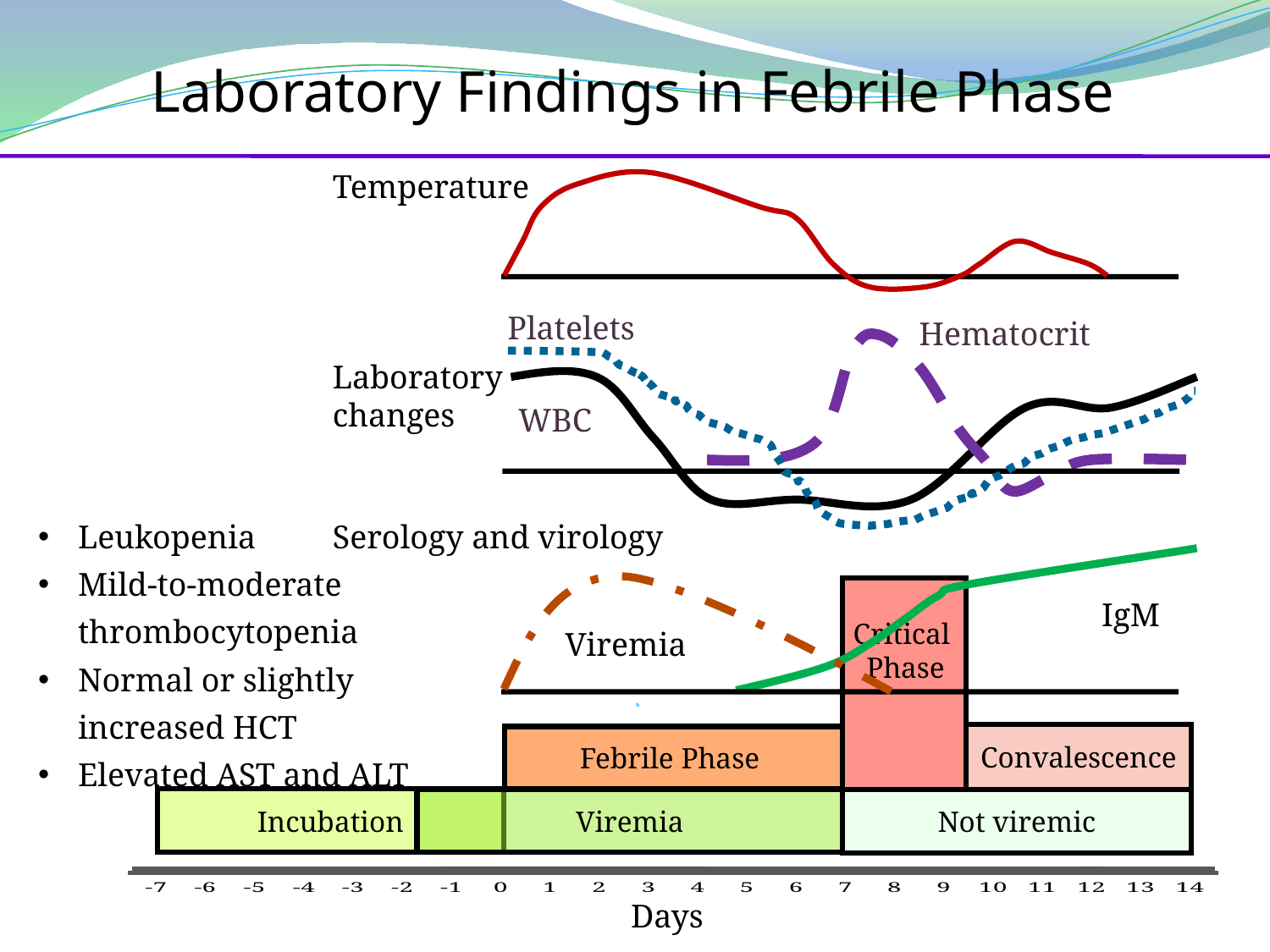
How many day ticks are shown on the horizontal axis, from -7 to 14? 22 What is the label on the horizontal axis of the diagram? Days Which phase follows the Critical Phase in the diagram? Convalescence Which phase is shown before day -2 on the bottom bar? Incubation Does the Platelets curve rise or fall between day 0 and day 7? fall Does the Hematocrit curve rise or fall between day 5 and day 7? rise Does the Temperature curve rise or fall between day 3 and day 7? fall Which bottom-bar label covers days 7 to 14? Not viremic On which day does the Febrile Phase end and the Critical Phase begin? 7 What is the title of the slide containing the diagram? Laboratory Findings in Febrile Phase On which day does the Febrile Phase begin according to the horizontal axis? 0